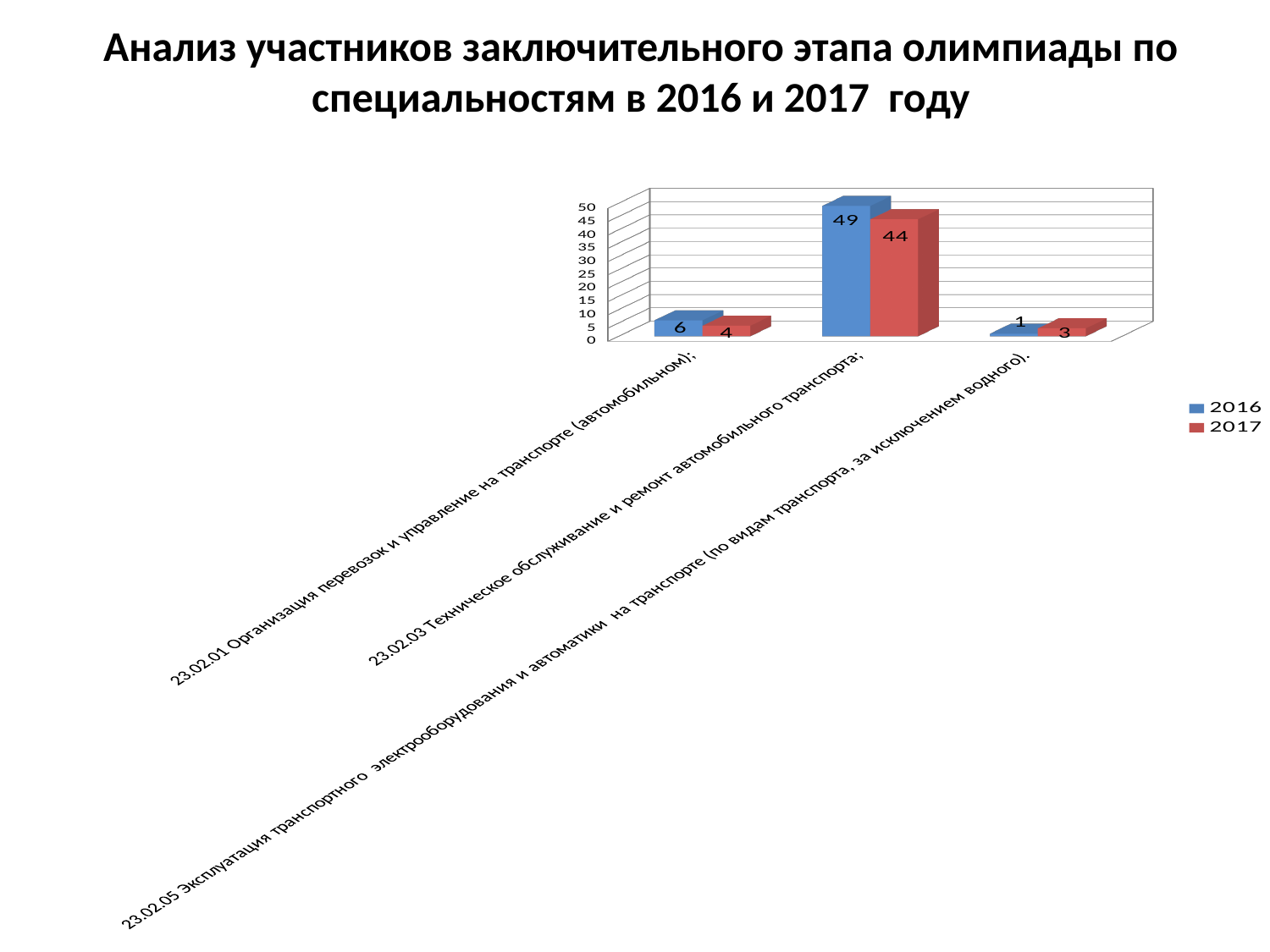
What is the difference between the 2016 and 2017 values for 23.02.03 Техническое обслуживание и ремонт автомобильного транспорта? 5 Which colour represents the 2017 series in the legend? Red What is the 2017 value for 23.02.01 Организация перевозок и управление на транспорте (автомобильном)? 4 What is the 2016 value for 23.02.03 Техническое обслуживание и ремонт автомобильного транспорта? 49 What kind of chart is shown on the slide? Bar chart Which specialty has the lowest 2017 value? 23.02.05 Эксплуатация транспортного электрооборудования и автоматики на транспорте How many specialties (categories) are shown on the x axis? 3 What is the 2017 value for 23.02.05 Эксплуатация транспортного электрооборудования и автоматики на транспорте? 3 How many series does the legend list? 2 Which specialty has the highest 2016 value? 23.02.03 Техническое обслуживание и ремонт автомобильного транспорта For 23.02.01 Организация перевозок и управление на транспорте, which year has the larger value, 2016 or 2017? 2016 What is the 2016 value for 23.02.05 Эксплуатация транспортного электрооборудования и автоматики на транспорте? 1